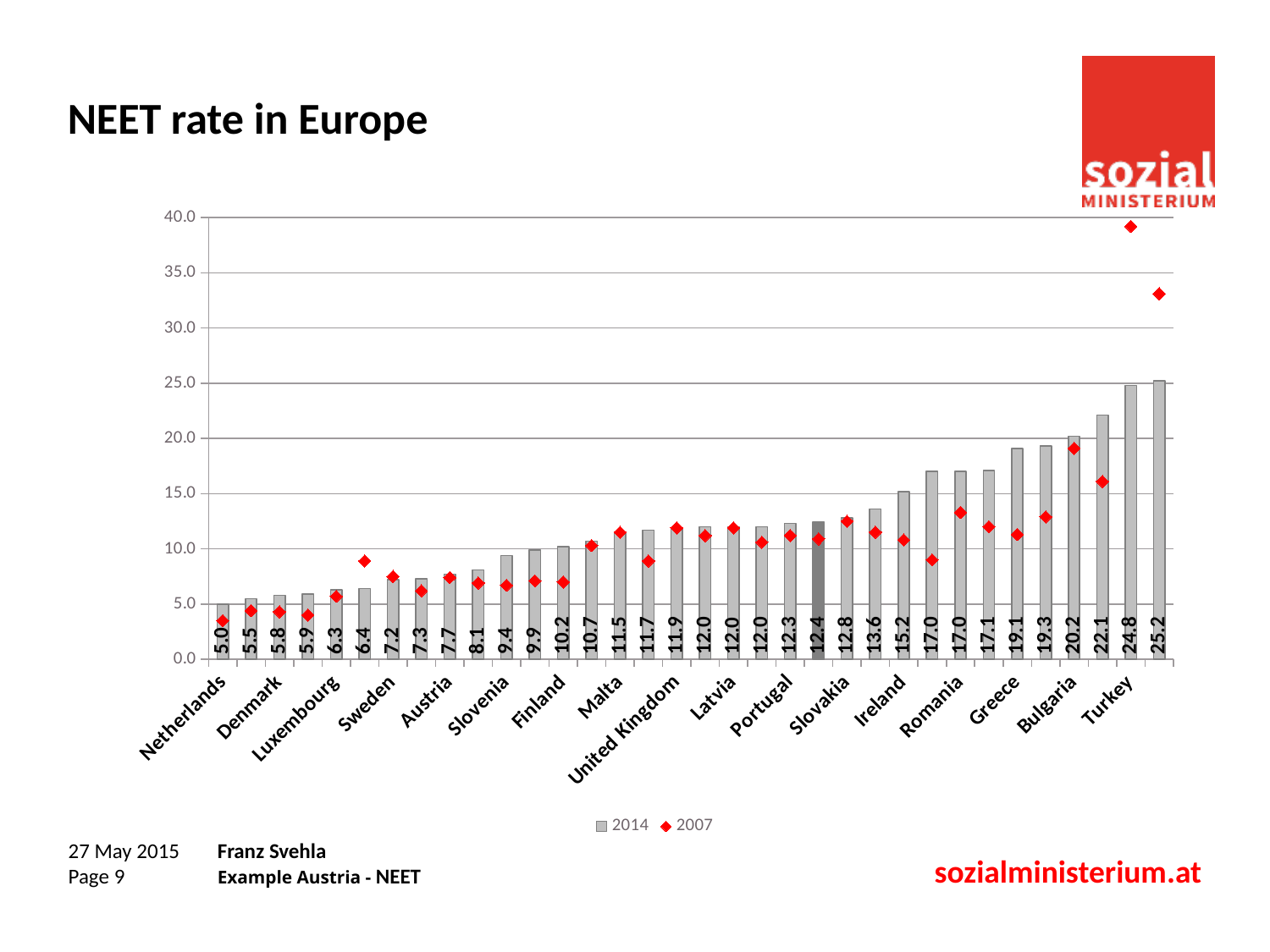
What is the 2014 NEET rate for Austria? 7.7 Do the 2014 bars rise or fall from left to right along the x axis? rise Which has the higher 2014 NEET rate, Greece or Ireland? Greece What is the highest 2014 value shown on the chart? 25.2 Is the 2007 value for Turkey greater or less than 35.0? greater What is the 2014 NEET rate for Turkey? 24.8 How many bars are plotted for the 2014 series? 34 What is the 2014 NEET rate for the Netherlands? 5.0 Which country has the lowest 2014 NEET rate? Netherlands What kind of chart is shown on the slide? bar chart What is the difference between the 2014 NEET rates of Turkey and the Netherlands? 19.8 How many series does the legend list? 2